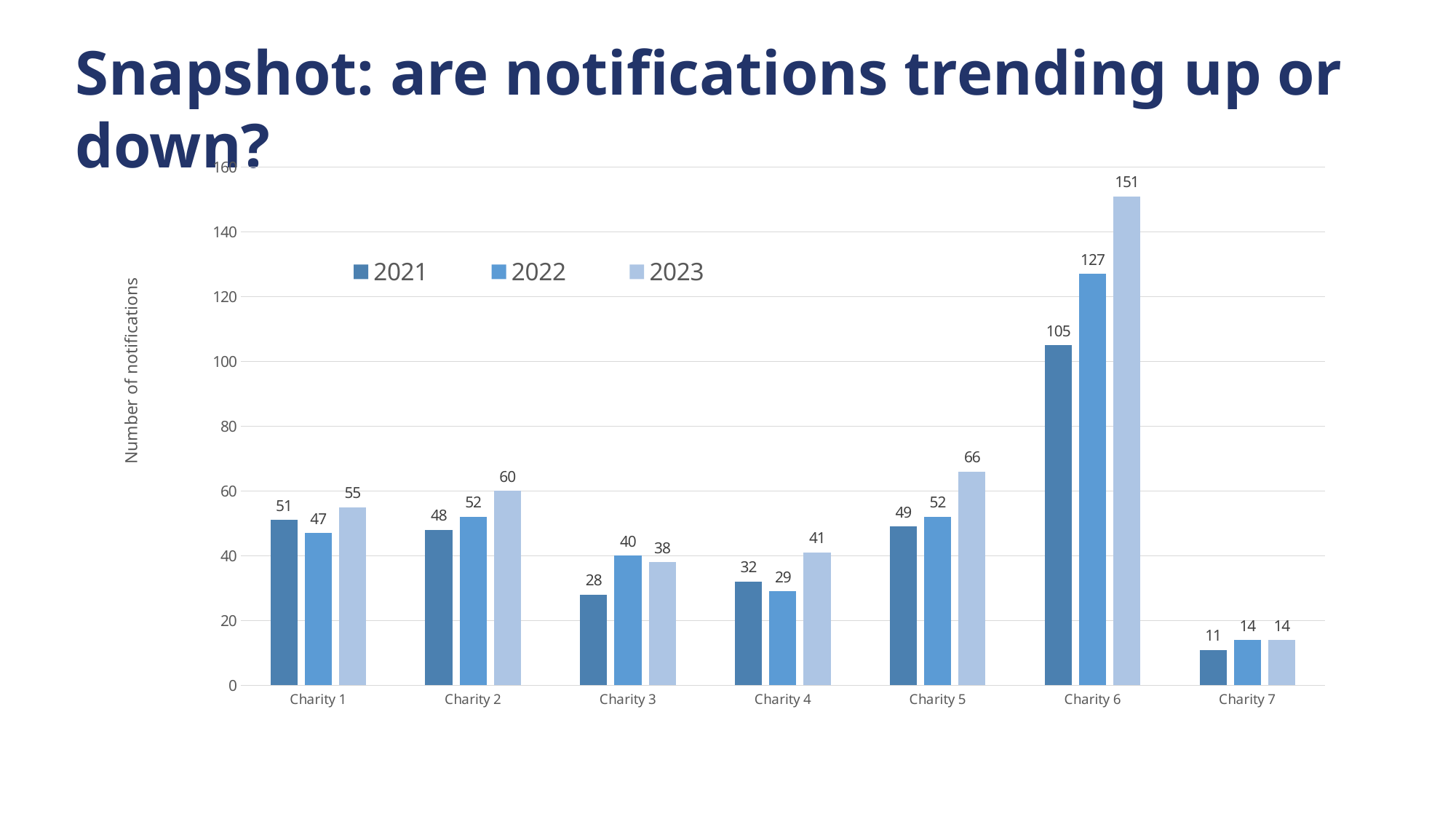
What is the number of notifications for Charity 6 in 2023? 151 Which charity has the highest number of notifications in 2022? Charity 6 What is the difference between the 2023 and 2021 values for Charity 6? 46 Which is larger for Charity 1: the 2021 value or the 2022 value? 2021 Do the values for Charity 5 rise or fall from 2021 to 2023? Rise What is the number of notifications for Charity 3 in 2021? 28 How many series does the legend list? 3 What is the number of notifications for Charity 5 in 2022? 52 Which charity has the lowest number of notifications in 2021? Charity 7 What is the label of the vertical axis? Number of notifications What kind of chart is shown on the slide? Bar chart How many charities are shown on the x axis? 7